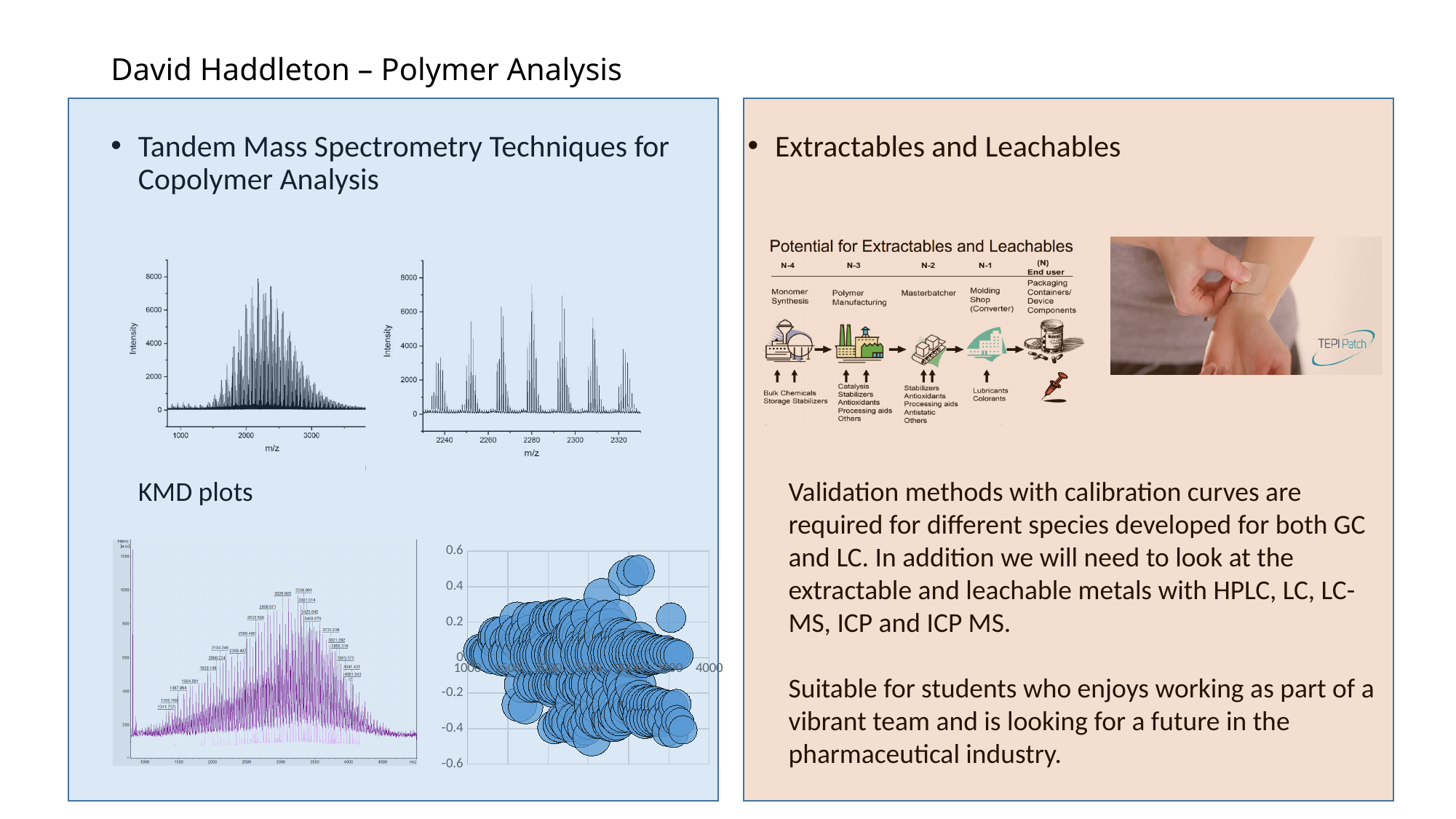
What kind of chart are the two plots of Intensity against m/z at the top of the left panel? line chart What kind of chart is the plot at the bottom right of the left panel, under the heading 'KMD plots'? bubble chart In the top-left Intensity vs m/z spectrum, is the tallest peak greater or less than 6000? greater In the bubble chart under 'KMD plots', what is the lowest value shown on the vertical axis? -0.6 In the top-left Intensity vs m/z spectrum, is the tallest peak located at an m/z greater or less than 2000? greater In the top-right Intensity vs m/z spectrum (m/z 2240 to 2320), is the tallest peak greater or less than 8000? less In the bubble chart under 'KMD plots', what is the highest value shown on the vertical axis? 0.6